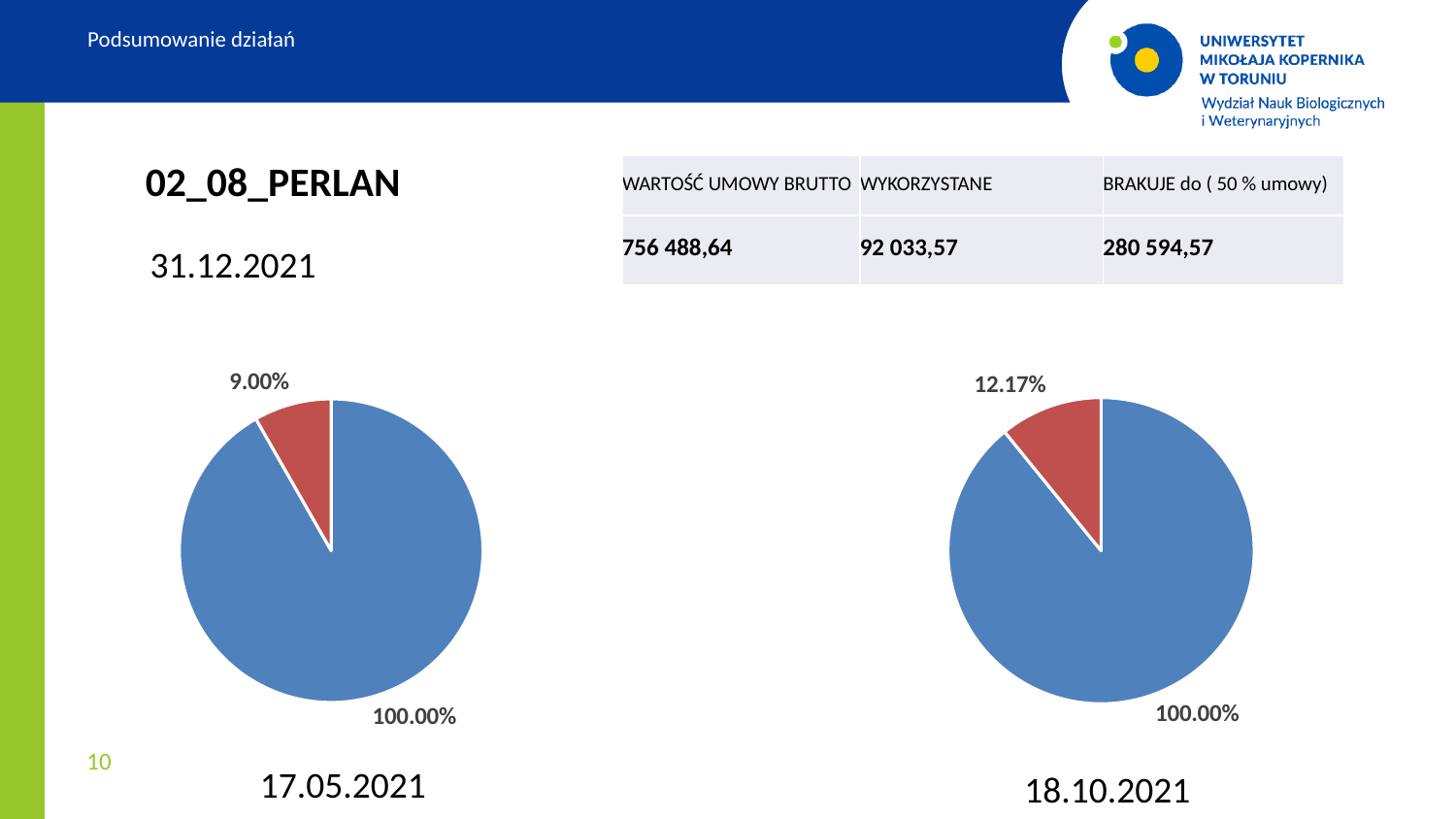
What colour is the smaller slice in the right pie chart (18.10.2021)? Red How many slices does the right pie chart (18.10.2021) have? 2 Which pie chart has the larger red slice, the left one (17.05.2021) or the right one (18.10.2021)? The right one (18.10.2021) What kind of chart is the right chart (dated 18.10.2021)? Pie chart In the right pie chart (18.10.2021), what label is shown on the blue slice? 100.00% In the right pie chart (18.10.2021), what percentage label is shown on the red slice? 12.17% How many slices does the left pie chart (17.05.2021) have? 2 In the left pie chart (17.05.2021), which slice is larger, the red one or the blue one? The blue one What kind of chart is the left chart (dated 17.05.2021)? Pie chart In the left pie chart (17.05.2021), what percentage label is shown on the red slice? 9.00% In the left pie chart (17.05.2021), what label is shown on the blue slice? 100.00% What is the difference between the red slice label in the right pie chart (12.17%) and the red slice label in the left pie chart (9.00%)? 3.17%